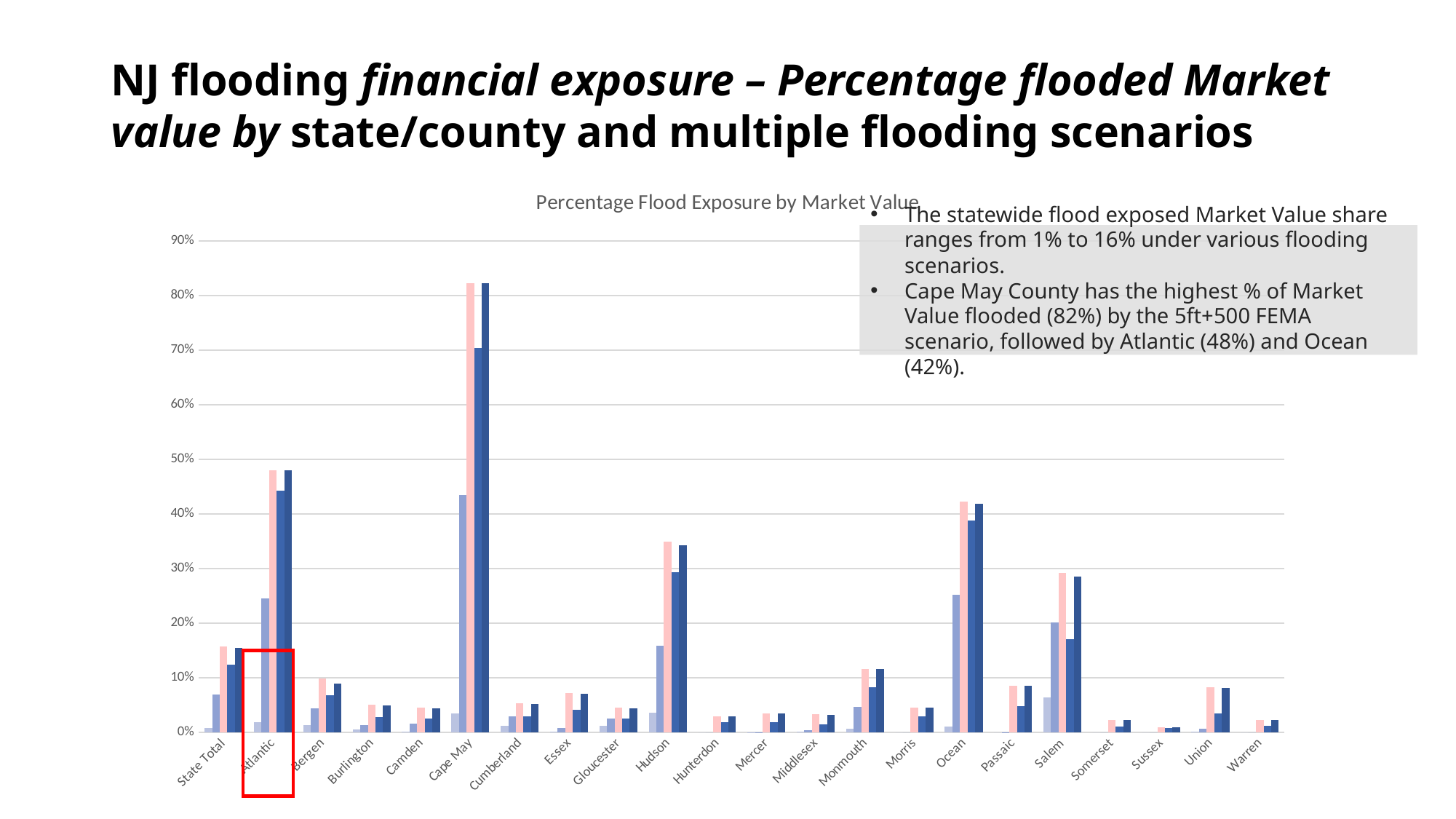
Is the tallest bar for Bergen greater or less than 20%? less What type of chart is shown on the slide? Bar chart Is the tallest bar for Cape May greater or less than 80%? greater Which category has the highest bar in the chart? Cape May Which has the taller bars, Ocean or Hudson? Ocean Is the tallest bar for Atlantic greater or less than 40%? greater Which has the taller bars, Cape May or Atlantic? Cape May How many categories are shown along the x axis of the chart? 22 Which category has the lowest bars in the chart? Sussex Which category on the x axis is outlined with a red box? Atlantic What is the title of the chart? Percentage Flood Exposure by Market Value